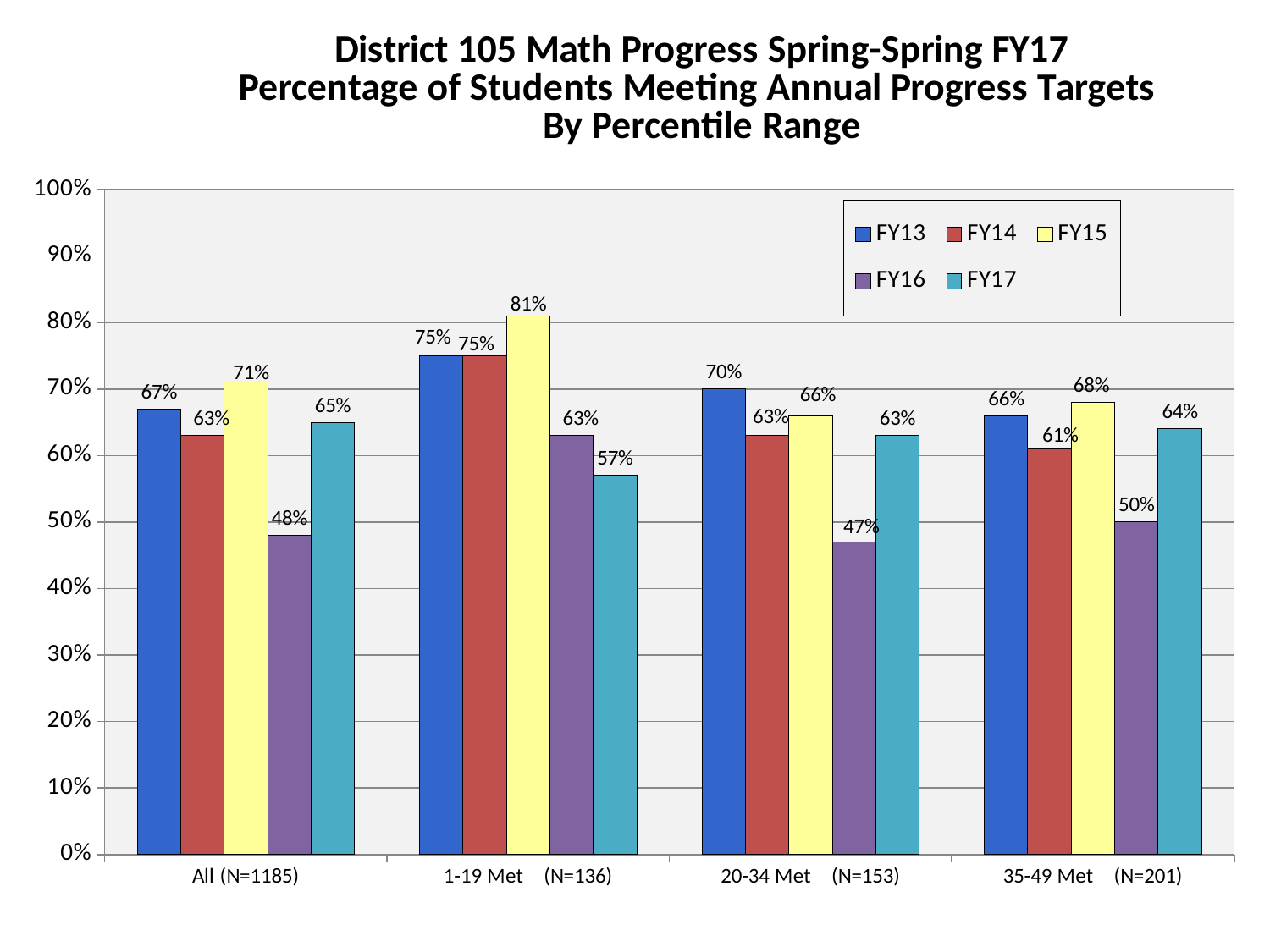
What kind of chart is shown on the slide? bar chart How many categories are shown on the x axis? 4 Which category has the lowest FY16 value? 20-34 Met (N=153) What is the FY16 value for the All (N=1185) category? 48% What is the difference between the FY15 and FY16 values for the 1-19 Met (N=136) category? 18% How many series does the legend list? 5 Which is larger for the 20-34 Met (N=153) category, the FY13 value or the FY17 value? FY13 Which category has the highest FY15 value? 1-19 Met (N=136) What is the FY17 value for the 35-49 Met (N=201) category? 64% Is the FY17 value for the 1-19 Met (N=136) category greater or less than 60%? less Which series is shown in yellow in the legend? FY15 What is the FY15 value for the 1-19 Met (N=136) category? 81%